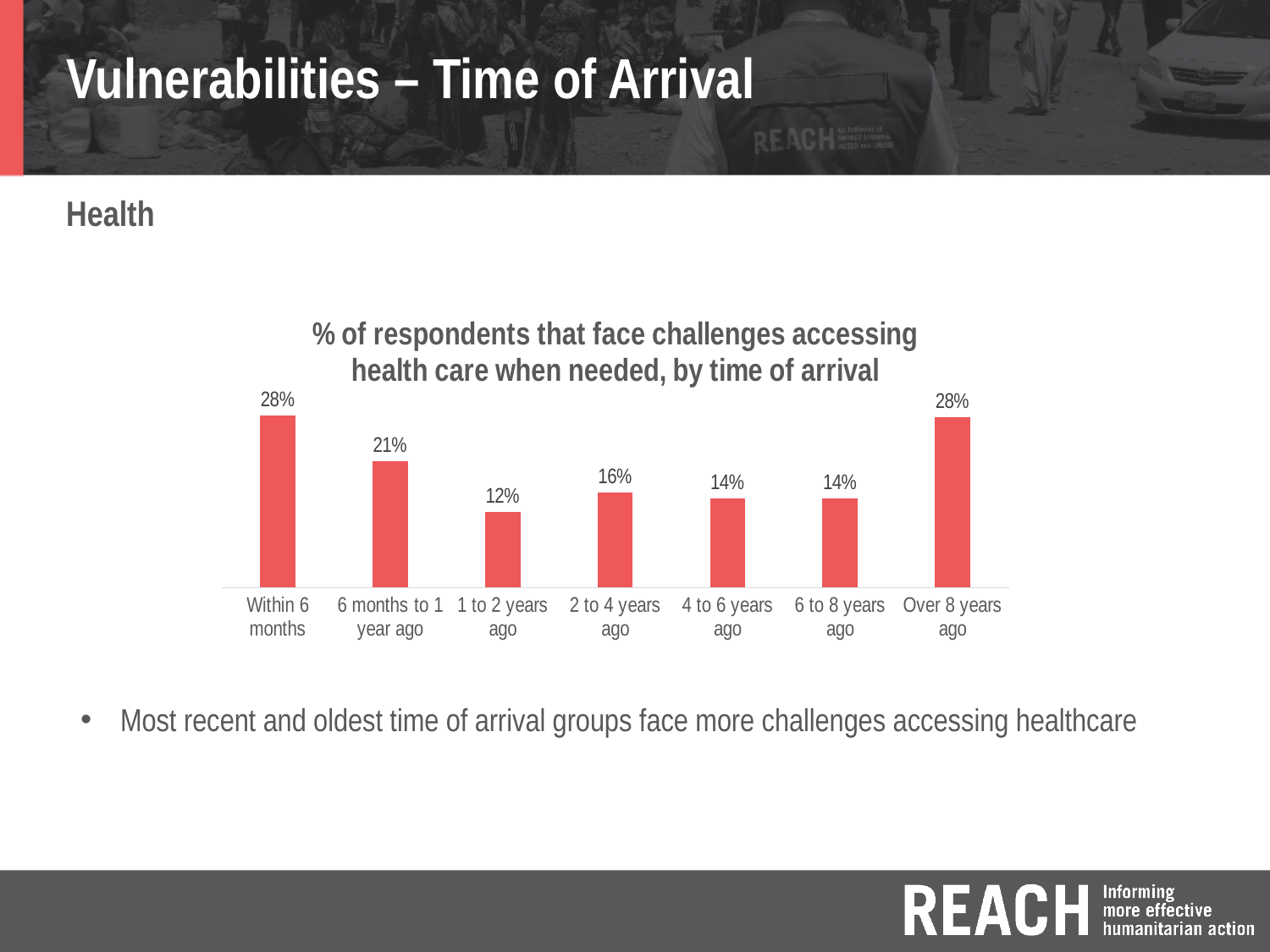
What is the value for the '6 months to 1 year ago' category? 21% Which time of arrival category has the lowest value? 1 to 2 years ago What is the difference between the values for '6 months to 1 year ago' and '2 to 4 years ago'? 5% What is the title of the chart? % of respondents that face challenges accessing health care when needed, by time of arrival What is the difference between the values for 'Within 6 months' and '1 to 2 years ago'? 16% What is the value for the 'Over 8 years ago' category? 28% Which is larger, the value for '6 months to 1 year ago' or the value for '4 to 6 years ago'? 6 months to 1 year ago What is the value for the '1 to 2 years ago' category? 12% How many time of arrival categories are shown on the chart? 7 What kind of chart is shown on the slide? Bar chart What is the value for the '2 to 4 years ago' category? 16% Do the values rise or fall from 'Within 6 months' to '1 to 2 years ago'? Fall